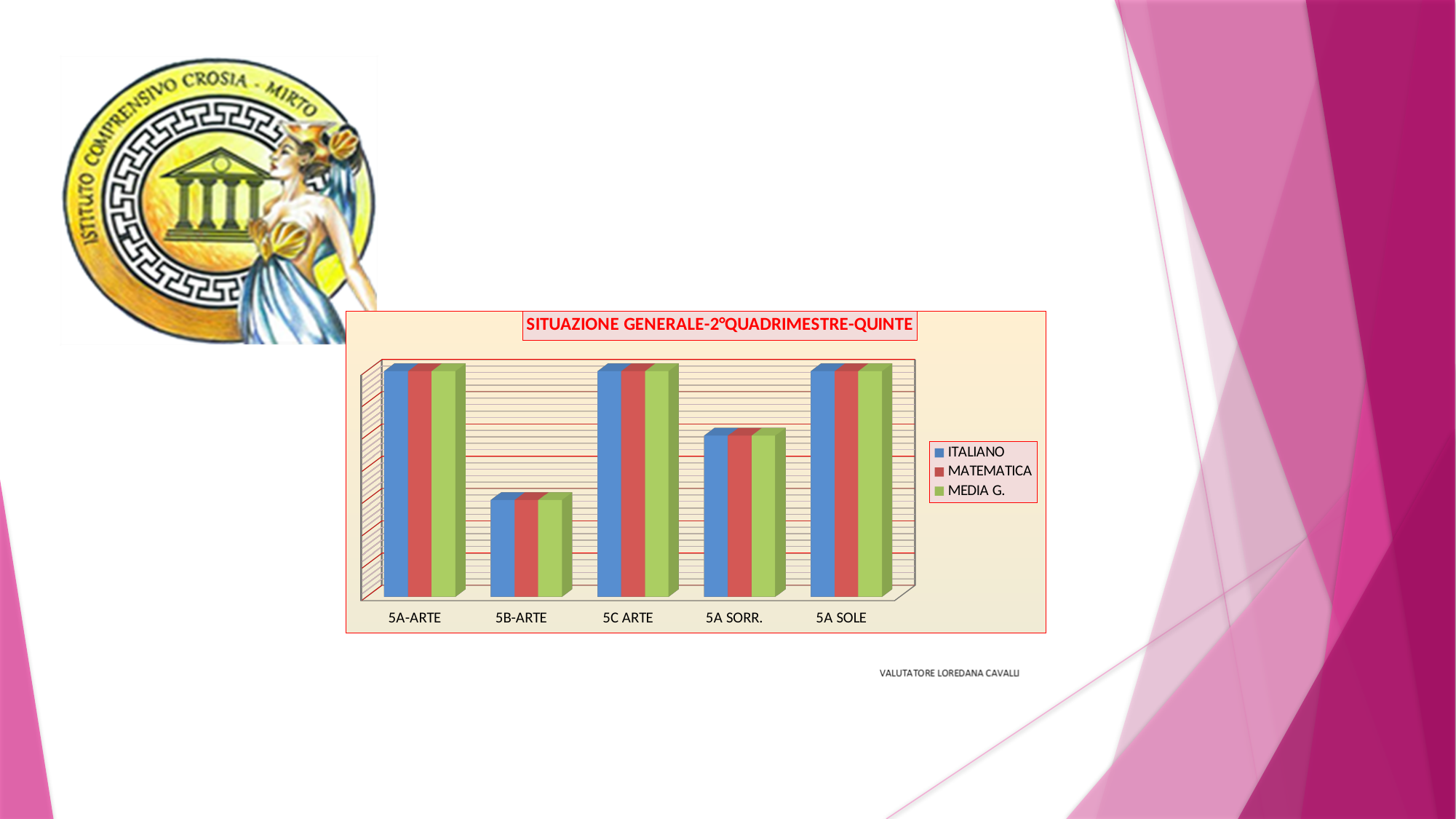
Which series is shown in green in the chart's legend? MEDIA G. How many series does the chart's legend list? 3 Is the MATEMATICA value for 5B-ARTE larger or smaller than the MATEMATICA value for 5C ARTE? smaller Is the MEDIA G. value for 5A-ARTE larger or smaller than the MEDIA G. value for 5A SORR.? larger Is the ITALIANO value for 5A SORR. larger or smaller than the ITALIANO value for 5B-ARTE? larger What kind of chart is shown on the slide? bar chart Which category has the lowest bars in the chart? 5B-ARTE What is the title of the chart? SITUAZIONE GENERALE-2°QUADRIMESTRE-QUINTE How many categories are shown on the x axis of the chart? 5